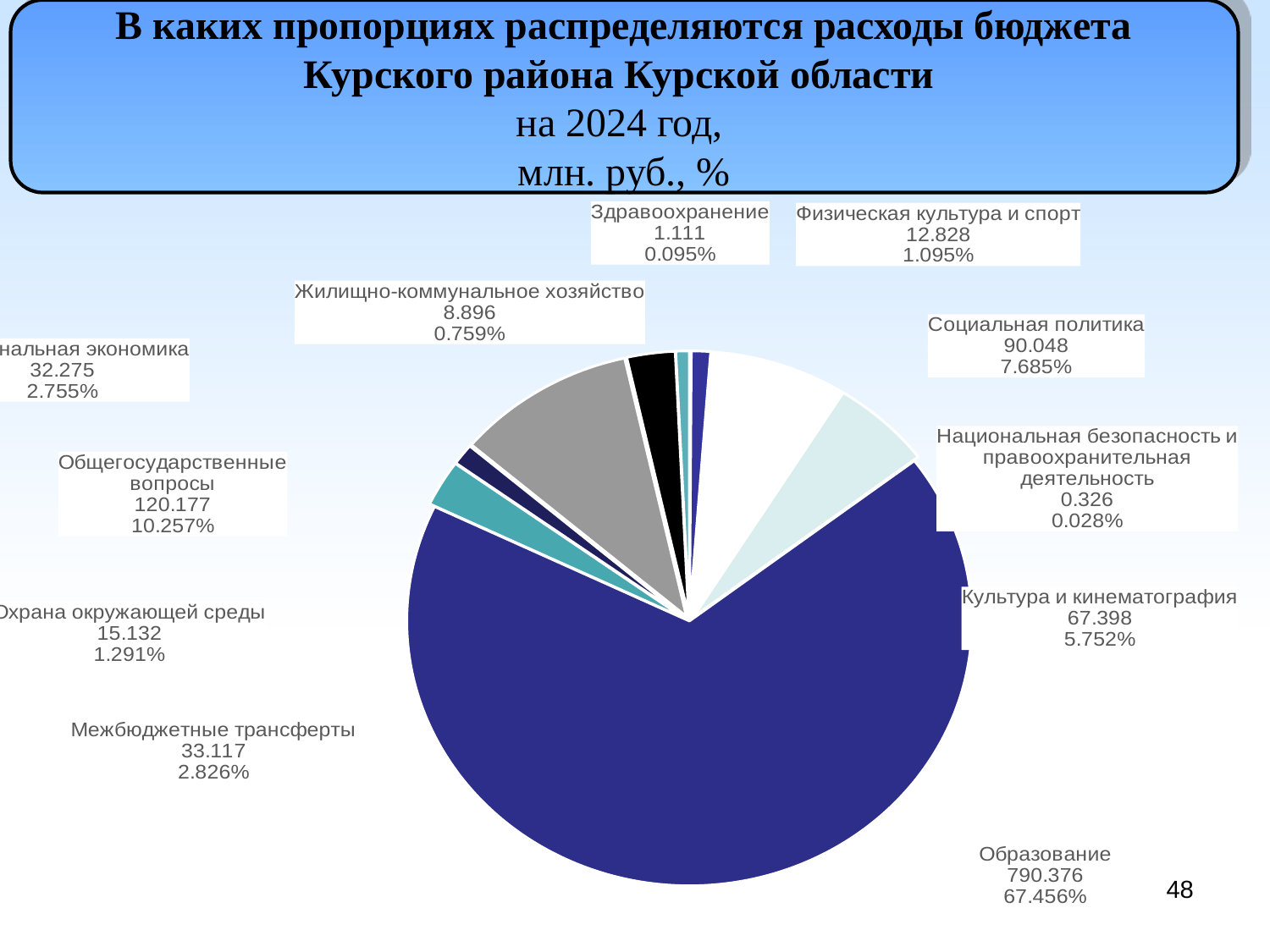
What share of the pie does Социальная политика represent? 7.685% How many categories are shown in the pie chart? 11 What is the difference between the values for Общегосударственные вопросы and Социальная политика? 30.129 What is the value for Общегосударственные вопросы? 120.177 What share of the pie does Образование represent? 67.456% What is the value for Образование? 790.376 Which category has the smallest value? Национальная безопасность и правоохранительная деятельность Which is larger: Культура и кинематография or Охрана окружающей среды? Культура и кинематография What is the value for Здравоохранение? 1.111 Which category has the largest value? Образование What kind of chart is shown on the slide? pie chart What is the difference between the values for Физическая культура и спорт and Жилищно-коммунальное хозяйство? 3.932